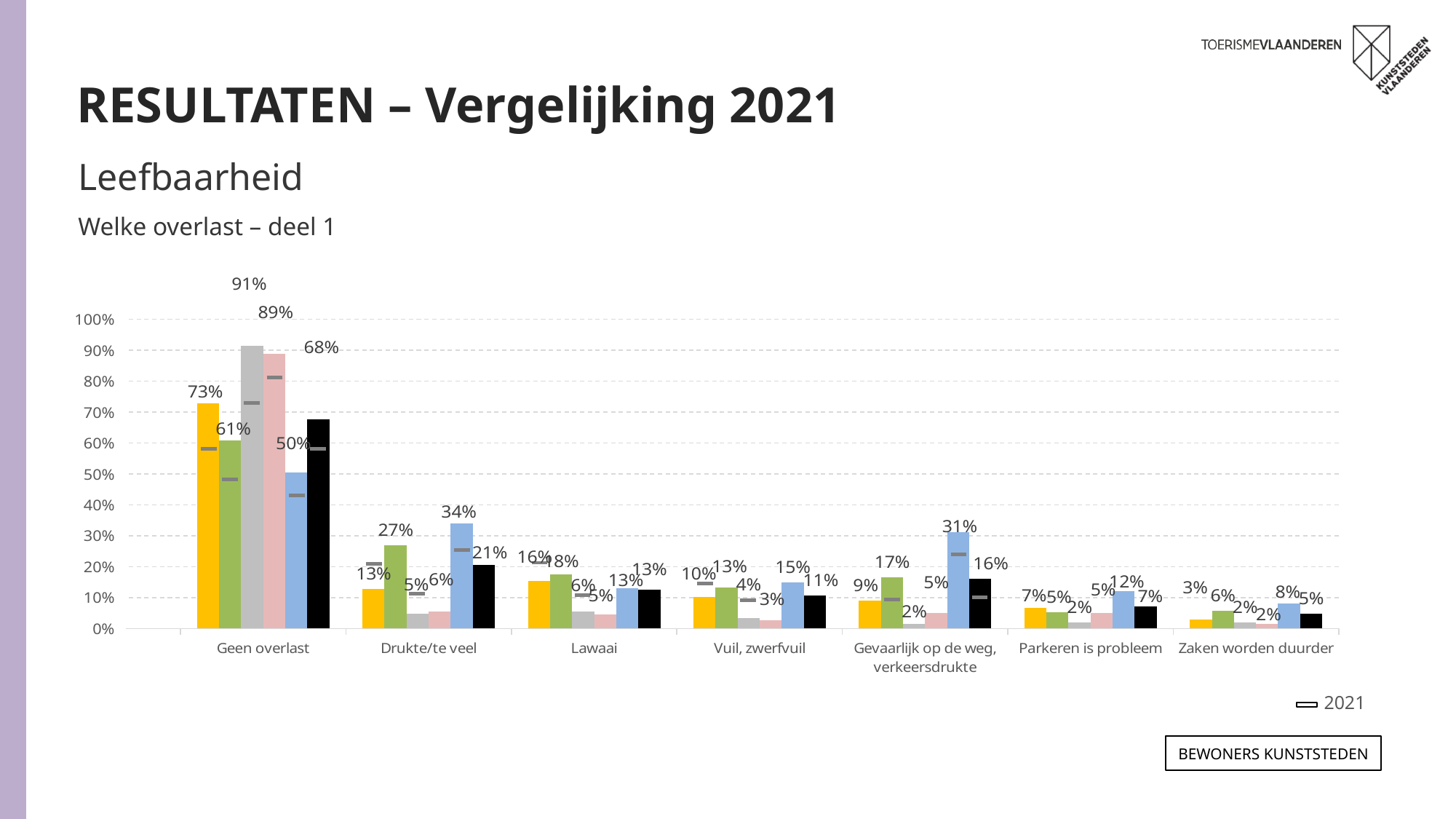
What is the lowest value labelled in the 'Gevaarlijk op de weg, verkeersdrukte' group? 2% What is the value of the black bar in the 'Geen overlast' group? 68% What entry does the chart legend show? 2021 What is the difference between the highest and lowest labelled values in the 'Geen overlast' group? 41% What is the value of the yellow bar in the 'Lawaai' group? 16% What is the highest value labelled in the 'Drukte/te veel' group? 34% How many categories are shown on the x axis of the chart? 7 Which group has the larger top value: 'Drukte/te veel' or 'Gevaarlijk op de weg, verkeersdrukte'? Drukte/te veel What is the highest value labelled in the 'Geen overlast' group? 91% Is the tallest bar in the 'Geen overlast' group greater or less than 80%? greater What is the lowest value labelled in the 'Geen overlast' group? 50% What kind of chart is shown on the slide? bar chart